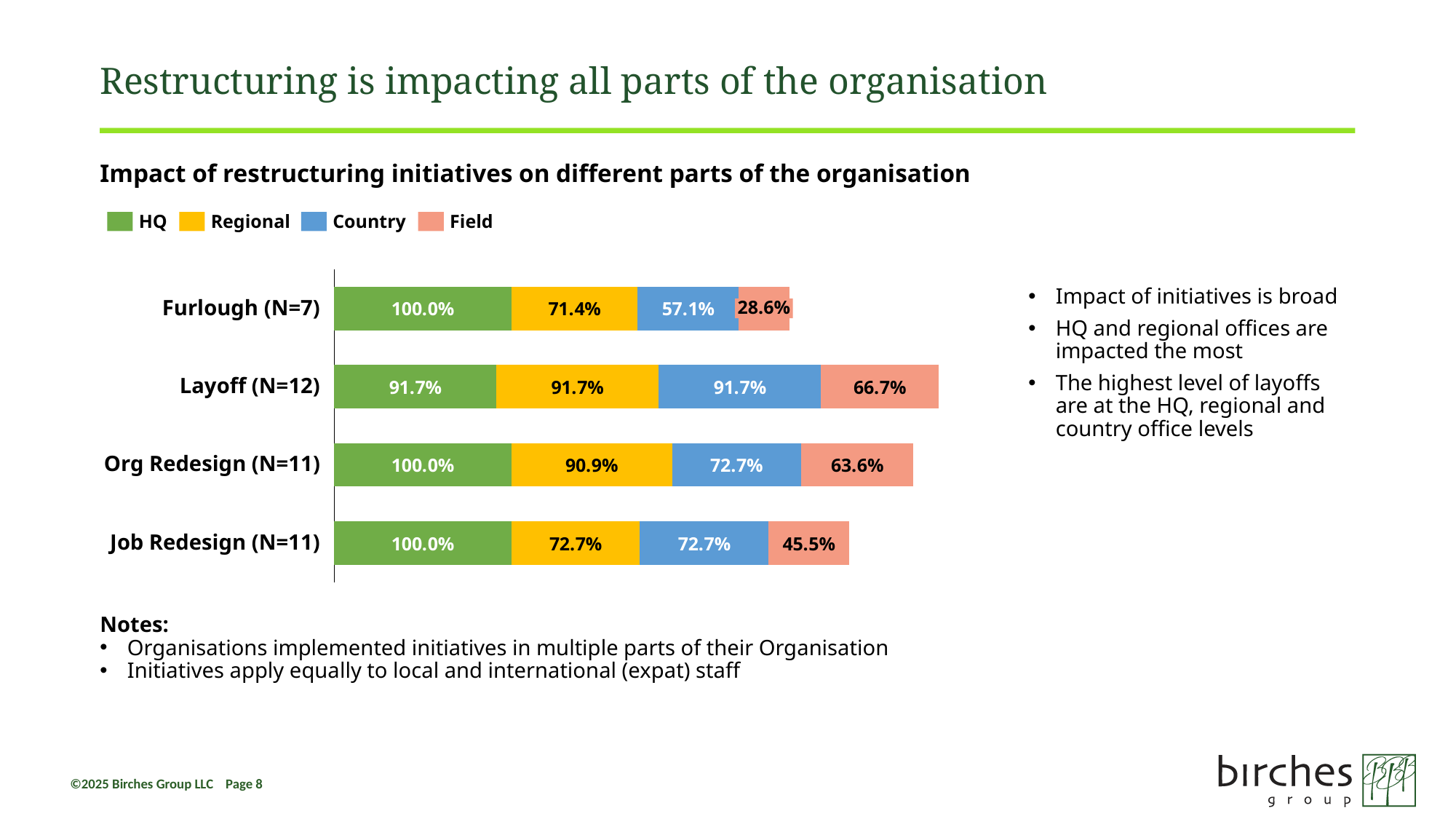
How many series does the legend list? 4 How many restructuring initiatives are shown on the chart? 4 Which initiative has the highest Field value? Layoff (N=12) What is the difference between the Regional values for Org Redesign (N=11) and Job Redesign (N=11)? 18.2 percentage points What kind of chart is shown on the slide? Stacked bar chart What is the difference between the Field values for Layoff (N=12) and Job Redesign (N=11)? 21.2 percentage points What is the Field value for Furlough (N=7)? 28.6% Which initiative has the lowest Country value? Furlough (N=7) Which is larger: the Country value for Org Redesign (N=11) or the Country value for Furlough (N=7)? Org Redesign (N=11) What is the Regional value for Org Redesign (N=11)? 90.9% What is the Country value for Layoff (N=12)? 91.7% What colour represents the Regional series in the legend? Yellow